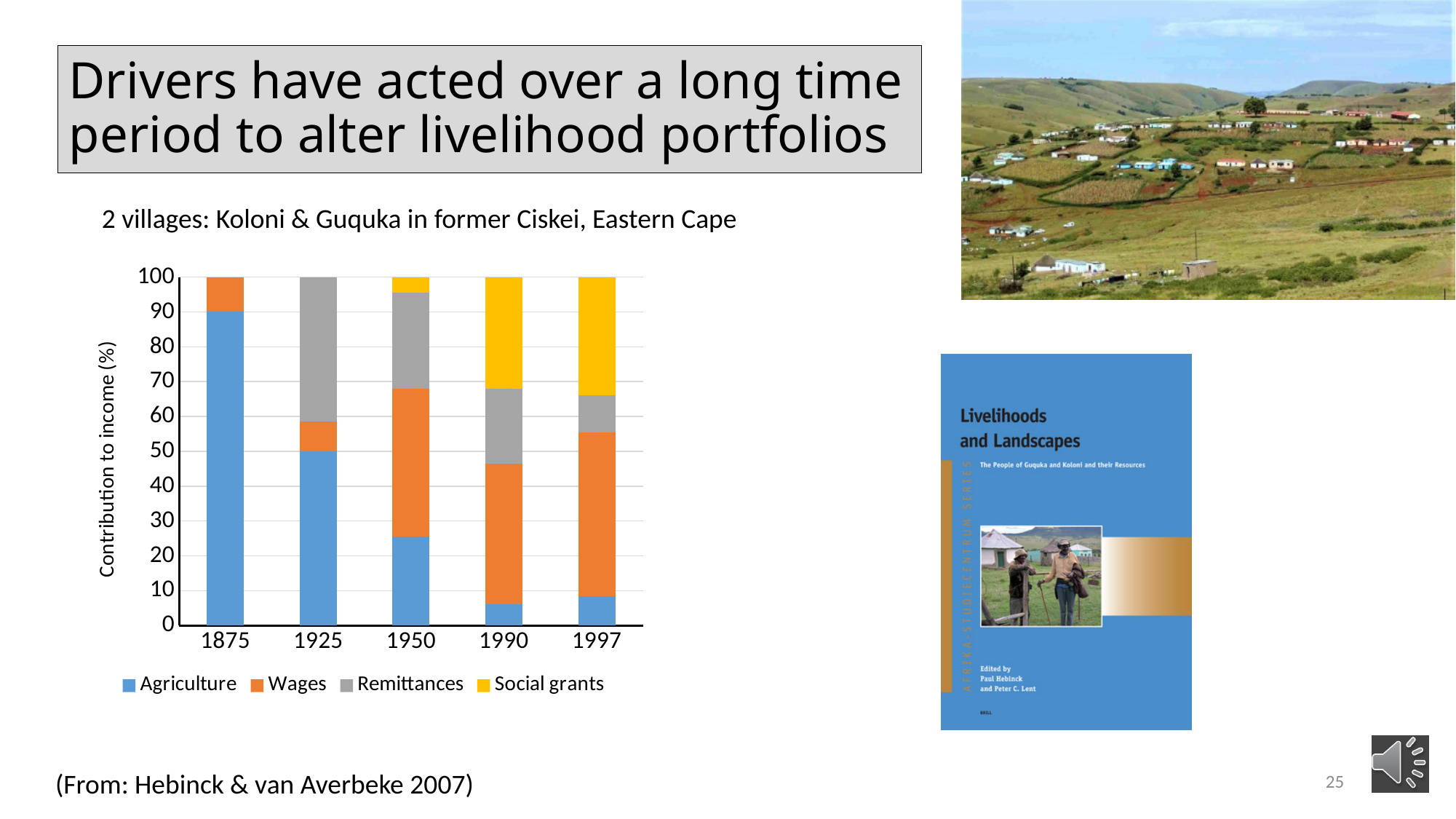
What kind of chart is shown on the slide? Stacked bar chart What is the label of the y axis of the chart? Contribution to income (%) Which series is shown in yellow in the chart? Social grants Which is larger in 1990: the Social grants contribution or the Agriculture contribution? Social grants What is the Agriculture contribution to income in 1925? 50 Does the Agriculture contribution to income rise or fall from 1875 to 1997? Fall How many series does the chart legend list? 4 How many years (categories) are shown on the x axis of the chart? 5 In which year is the Agriculture contribution to income highest? 1875 Is the Wages contribution to income in 1997 greater or less than 40? greater What is the Agriculture contribution to income in 1875? 90 Is the Agriculture contribution to income in 1950 greater or less than 30? less